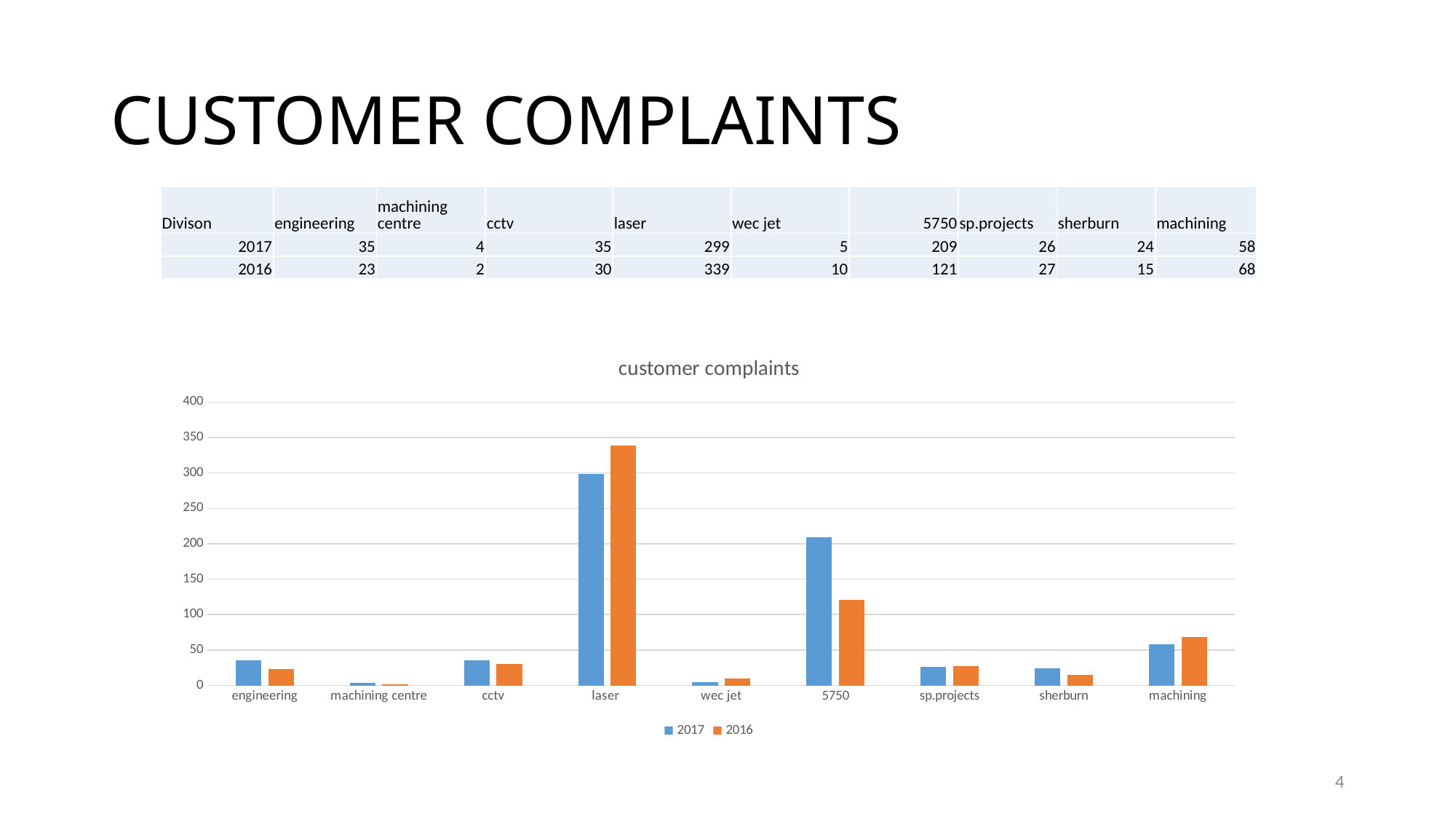
What type of chart is shown on the slide? bar chart What is the number of customer complaints for 5750 in 2016? 121 What is the number of customer complaints for machining in 2016? 68 Which division has the highest number of complaints in 2016? laser How many divisions are shown on the x axis of the chart? 9 Is the value for laser in 2016 greater or less than 300? greater Which is larger for 5750: the 2017 value or the 2016 value? 2017 What is the difference between the 2016 and 2017 complaints for laser? 40 How many series does the chart legend list? 2 What is the number of customer complaints for laser in 2017? 299 Which division has the lowest number of complaints in 2017? machining centre What is the title of the chart? customer complaints